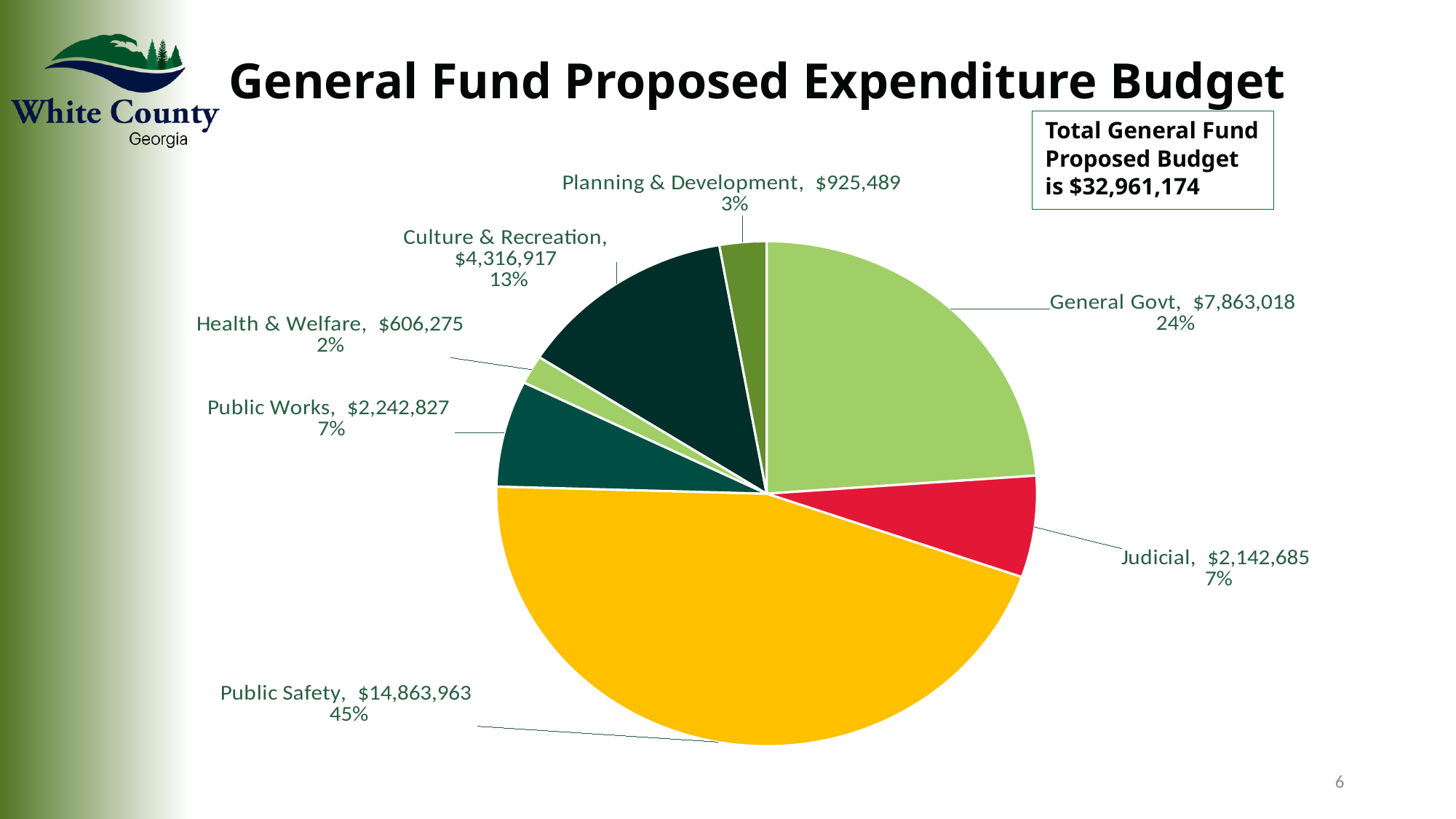
Which is larger, the expenditure for Planning & Development or for Health & Welfare? Planning & Development What is the proposed expenditure for Health & Welfare? $606,275 What is the difference between the Public Works and Judicial expenditures? $100,142 What percentage share of the pie does Culture & Recreation represent? 13% What type of chart is shown on the slide? Pie chart Which category has the largest share of the General Fund proposed expenditure budget? Public Safety Which category has the smallest share of the General Fund proposed expenditure budget? Health & Welfare What is the proposed expenditure for Culture & Recreation? $4,316,917 What percentage share of the pie does Public Safety represent? 45% What is the proposed expenditure for Public Safety? $14,863,963 What is the proposed expenditure for General Govt? $7,863,018 How many categories are shown in the pie chart? 7